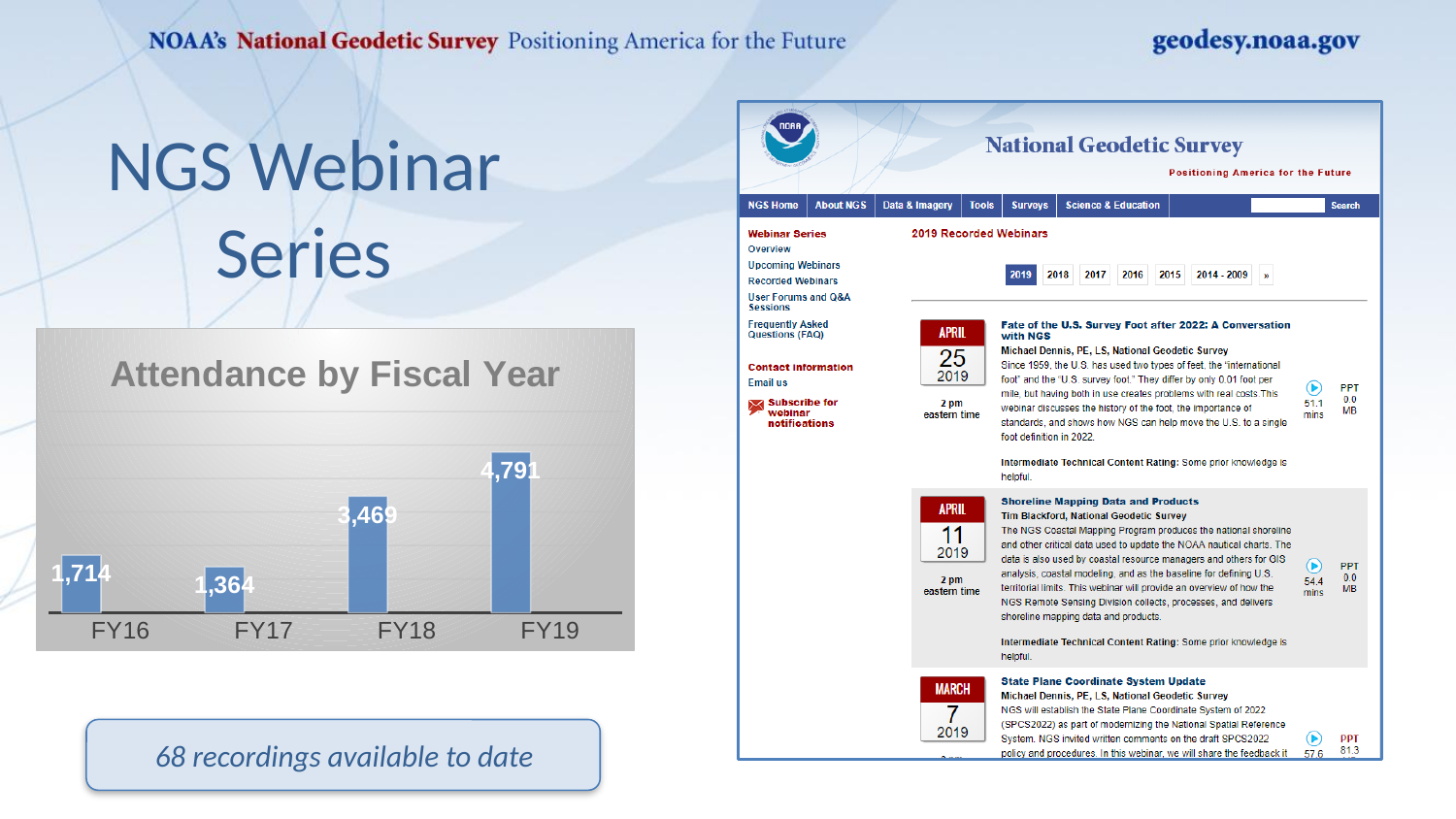
How many fiscal years are shown in the Attendance by Fiscal Year chart? 4 What is the title of the chart on the slide? Attendance by Fiscal Year What is the attendance value for FY19 in the Attendance by Fiscal Year chart? 4,791 Which fiscal year has the highest attendance in the chart? FY19 Which fiscal year has the lowest attendance in the chart? FY17 Which has higher attendance, FY16 or FY18? FY18 What kind of chart is the Attendance by Fiscal Year chart? Bar chart What is the difference in attendance between FY16 and FY17? 350 What is the attendance value for FY16 in the Attendance by Fiscal Year chart? 1,714 What is the attendance value for FY17 in the Attendance by Fiscal Year chart? 1,364 What is the difference in attendance between FY19 and FY18? 1,322 What is the attendance value for FY18 in the Attendance by Fiscal Year chart? 3,469